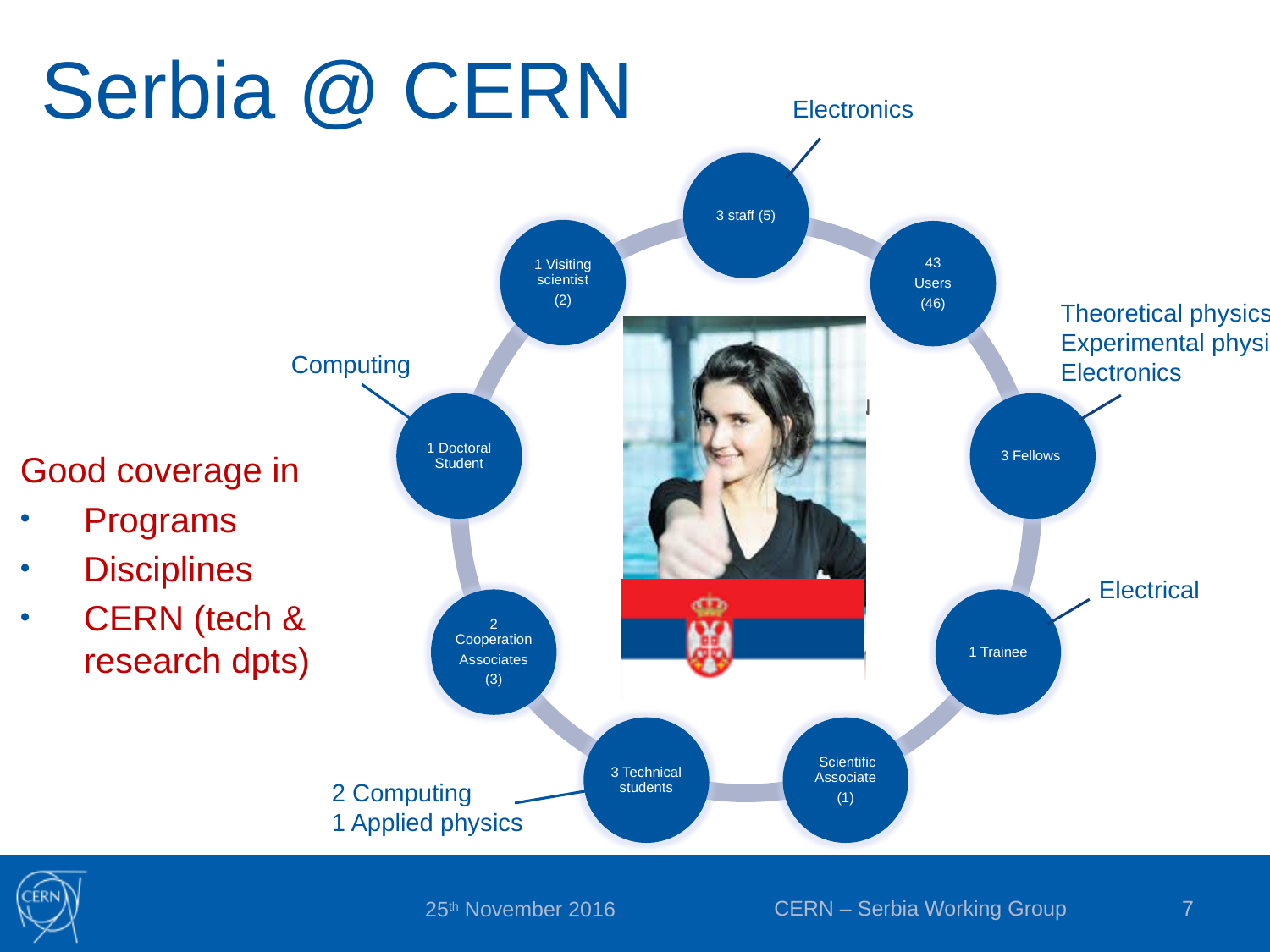
In the circular diagram, how many Users from Serbia are shown at CERN? 43 Which discipline label is connected to the '1 Doctoral Student' circle? Computing In the circular diagram, how many Trainees are shown? 1 Which category in the circular diagram has the largest number of people? Users In the circular diagram, what number appears in parentheses next to '3 staff'? 5 How many circles (categories) make up the circular diagram? 9 In the circular diagram, how many Technical students are shown? 3 In the circular diagram, what number appears in parentheses for Cooperation Associates? 3 Which discipline label is connected to the '1 Trainee' circle? Electrical In the circular diagram, how many Doctoral Students are shown? 1 In the circular diagram, how many Fellows are shown? 3